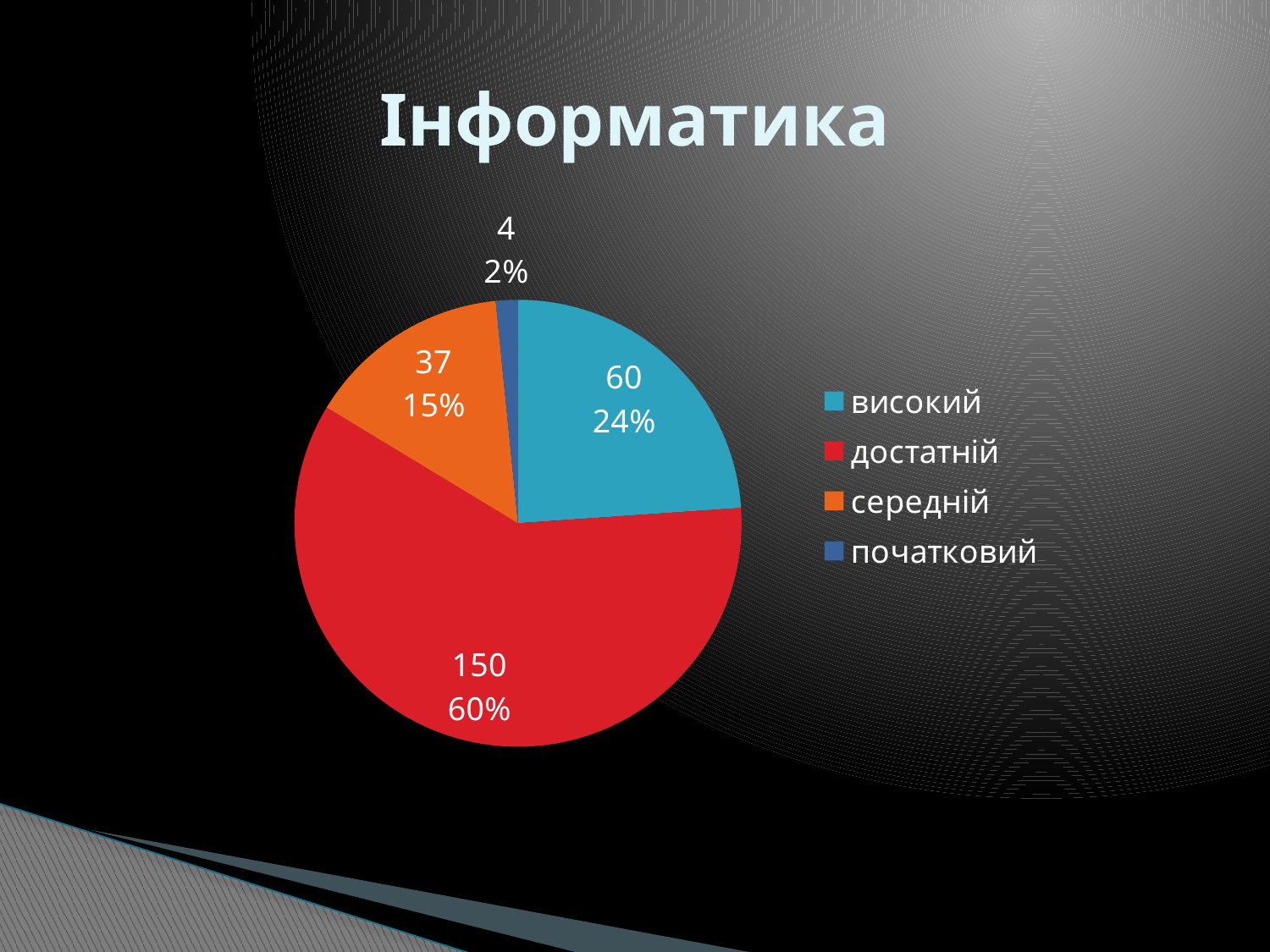
Which category has the smallest slice? початковий What is the value for середній? 37 What is the difference between the values for достатній and високий? 90 How many categories does the legend list? 4 What share of the pie does середній take? 15% Which category has the largest slice? достатній What is the value for достатній? 150 What share of the pie does достатній take? 60% What is the value for початковий? 4 What kind of chart is shown on the slide? pie chart What is the value for високий? 60 Which is larger, the value for високий or the value for середній? високий